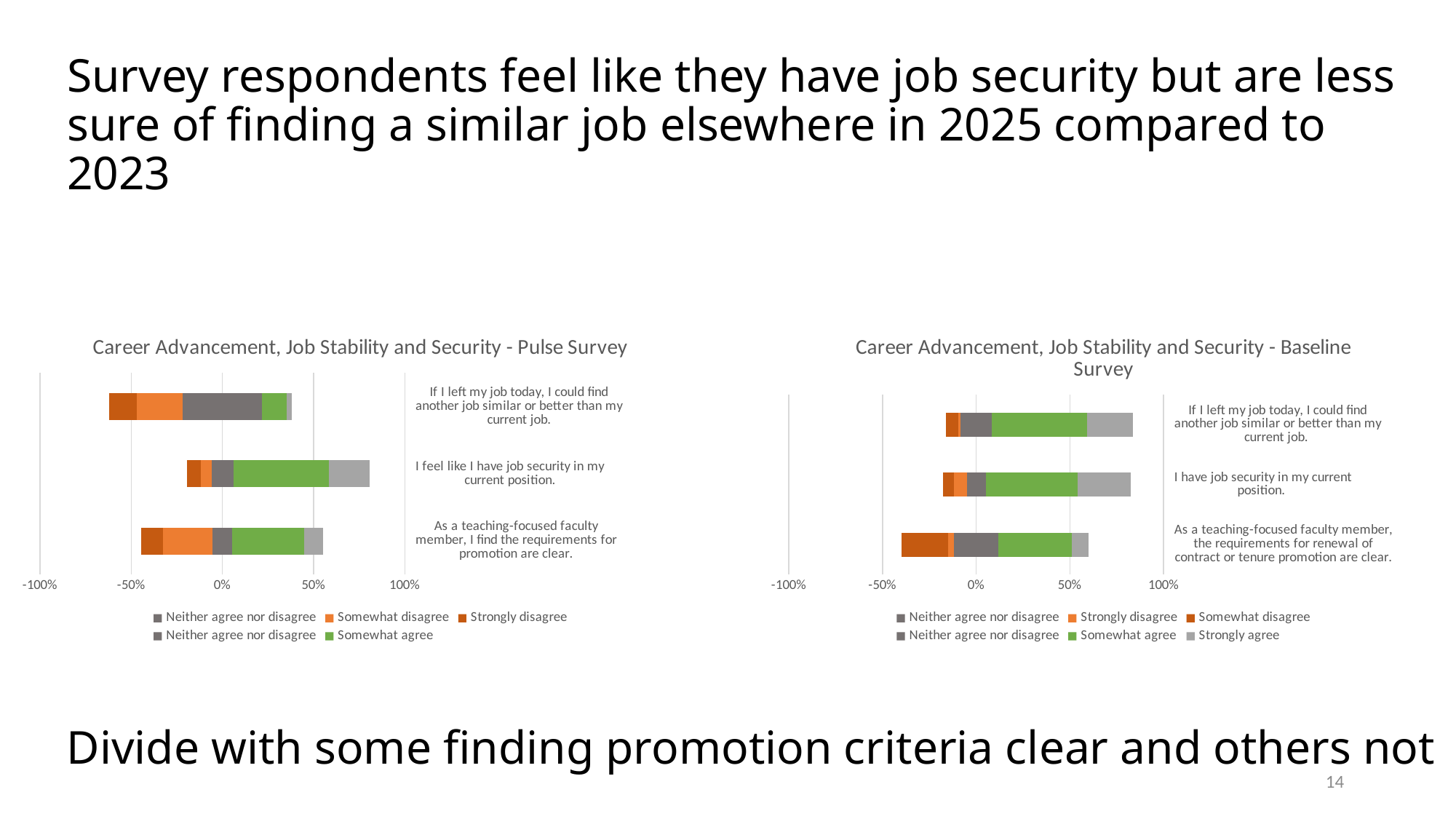
What kind of chart is the 'Career Advancement, Job Stability and Security - Pulse Survey' chart? Stacked bar chart How many statements (categories) are plotted in the 'Career Advancement, Job Stability and Security - Pulse Survey' chart? 3 How many statements (categories) are plotted in the 'Career Advancement, Job Stability and Security - Baseline Survey' chart? 3 Which legend entry appears in the Baseline Survey chart's legend but not in the Pulse Survey chart's legend? Strongly agree In the Pulse Survey chart, does the agree side of the bar for 'If I left my job today, I could find another job similar or better than my current job' extend to greater or less than 50%? less In the Baseline Survey chart, does the agree side of the bar for 'If I left my job today, I could find another job similar or better than my current job' extend to greater or less than 50%? greater In the Pulse Survey chart, does the agree side of the bar for 'I feel like I have job security in my current position' extend to greater or less than 50%? greater In the Pulse Survey chart, which statement has the longest agree (positive) portion of its bar? I feel like I have job security in my current position. How many entries does the legend of the 'Career Advancement, Job Stability and Security - Pulse Survey' chart list? 5 How many entries does the legend of the 'Career Advancement, Job Stability and Security - Baseline Survey' chart list? 6 In the Baseline Survey chart, which statement has the longest disagree (negative) portion of its bar? As a teaching-focused faculty member, the requirements for renewal of contract or tenure promotion are clear. In the Pulse Survey chart, which statement has the longest disagree (negative) portion of its bar? If I left my job today, I could find another job similar or better than my current job.